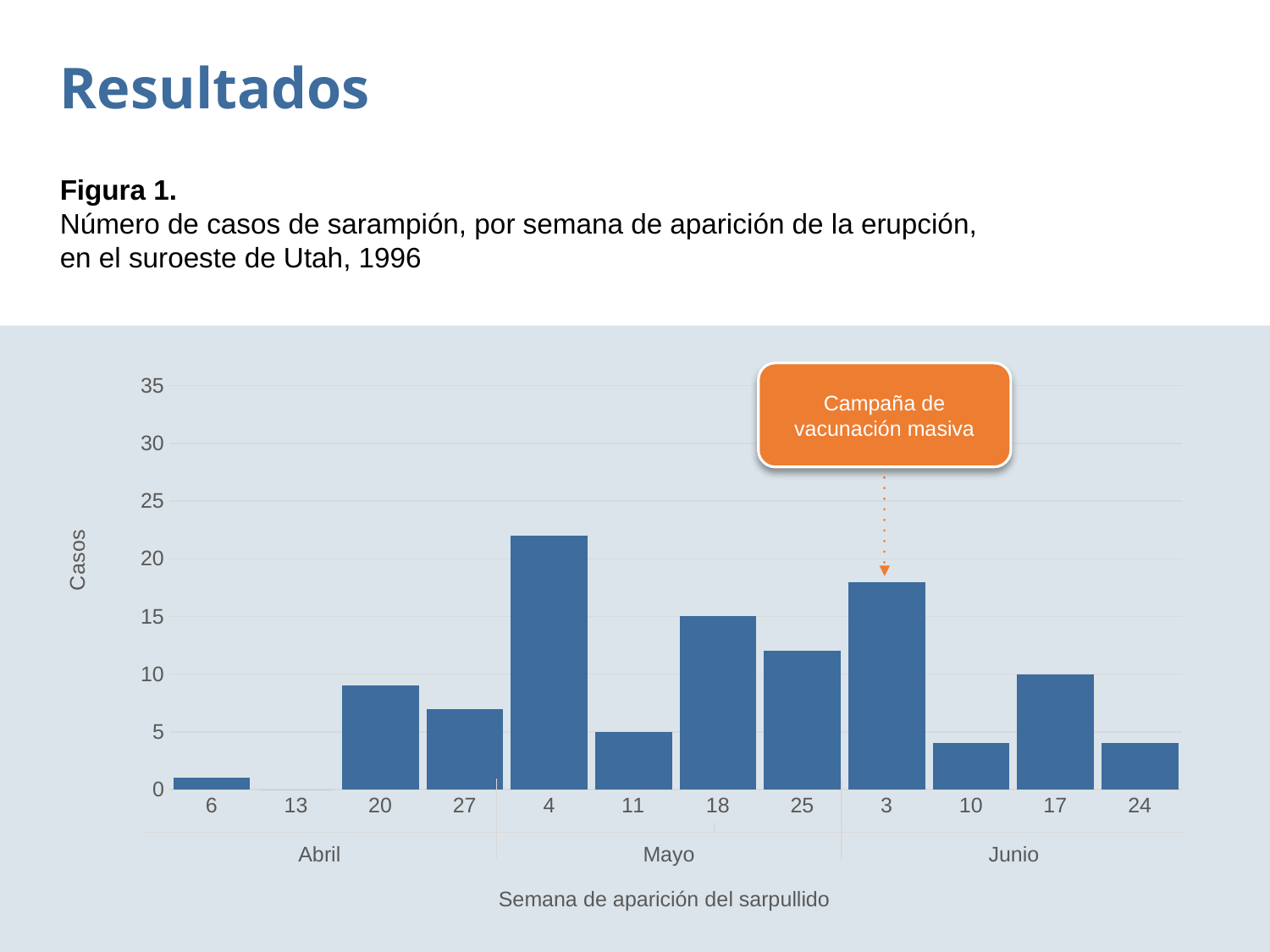
Is the number of cases for the week of 3 de Junio greater or less than 20? less Which week of rash onset has the highest number of cases? 4 de Mayo What does the orange callout on the chart say? Campaña de vacunación masiva Which has more cases, the week of 18 de Mayo or the week of 25 de Mayo? 18 de Mayo Which has more cases, the week of 4 de Mayo or the week of 3 de Junio? 4 de Mayo How many weeks (bars/categories) are shown on the x axis? 12 What kind of chart is shown on the slide? bar chart Which week in Abril shows no cases at all? 13 de Abril Is the number of cases for the week of 4 de Mayo greater or less than 20? greater Is the number of cases for the week of 20 de Abril greater or less than 10? less What is the label of the y axis? Casos